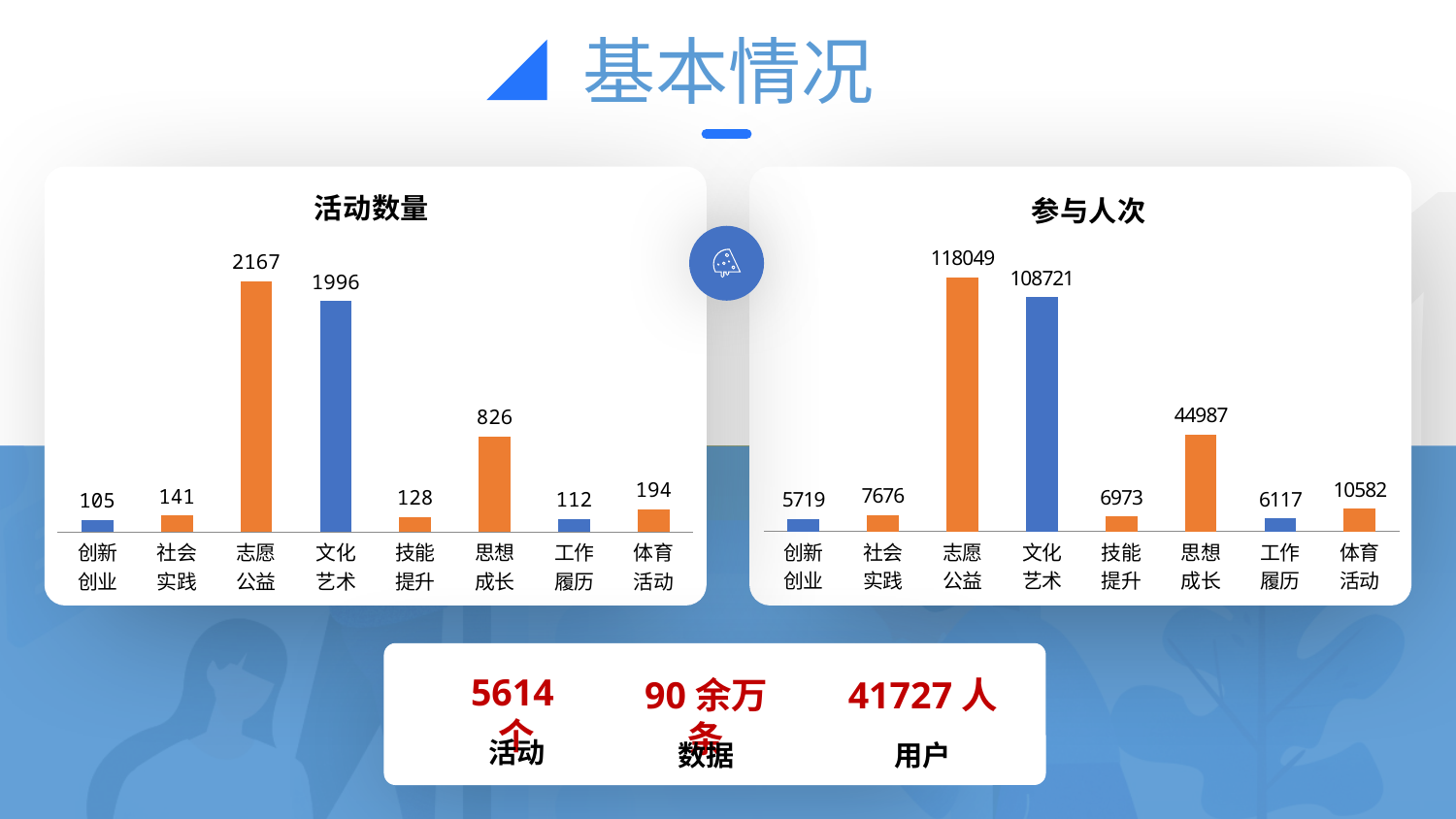
In the 参与人次 chart, what is the value for 体育活动? 10582 In the 活动数量 chart, which category has the highest value? 志愿公益 In the 参与人次 chart, which category has the lowest value? 创新创业 What type of chart is the 参与人次 chart? bar chart In the 参与人次 chart, which is larger, 社会实践 or 技能提升? 社会实践 In the 参与人次 chart, what is the value for 文化艺术? 108721 How many categories are shown in the 活动数量 chart? 8 In the 活动数量 chart, what is the value for 思想成长? 826 In the 活动数量 chart, which category has the lowest value? 创新创业 In the 活动数量 chart, what is the value for 志愿公益? 2167 In the 活动数量 chart, what is the difference between 体育活动 and 社会实践? 53 In the 参与人次 chart, what is the difference between 志愿公益 and 文化艺术? 9328